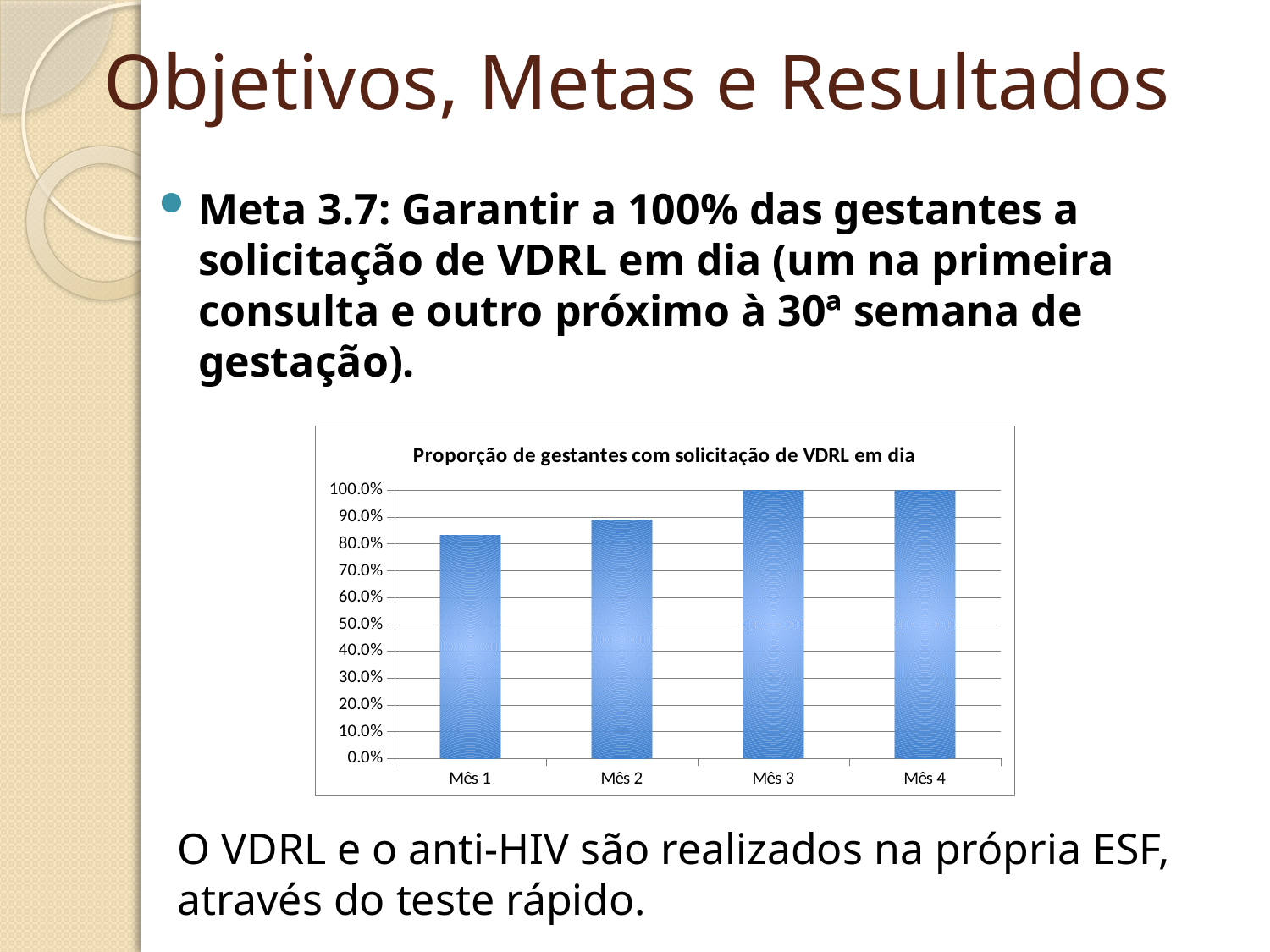
What is the value for Mês 3 in the chart? 100.0% What type of chart is shown on the slide? Bar chart Is the value for Mês 1 greater or less than 70.0%? greater What is the value for Mês 4 in the chart? 100.0% Is the value for Mês 2 greater or less than 80.0%? greater Do the values rise or fall from Mês 1 to Mês 4? rise What is the maximum value shown on the y axis of the chart? 100.0% Which is larger, the value for Mês 1 or the value for Mês 2? Mês 2 Which month has the lowest value in the chart? Mês 1 What is the title of the chart? Proporção de gestantes com solicitação de VDRL em dia Is the value for Mês 1 greater or less than 90.0%? less How many categories (months) are shown on the x axis of the chart? 4